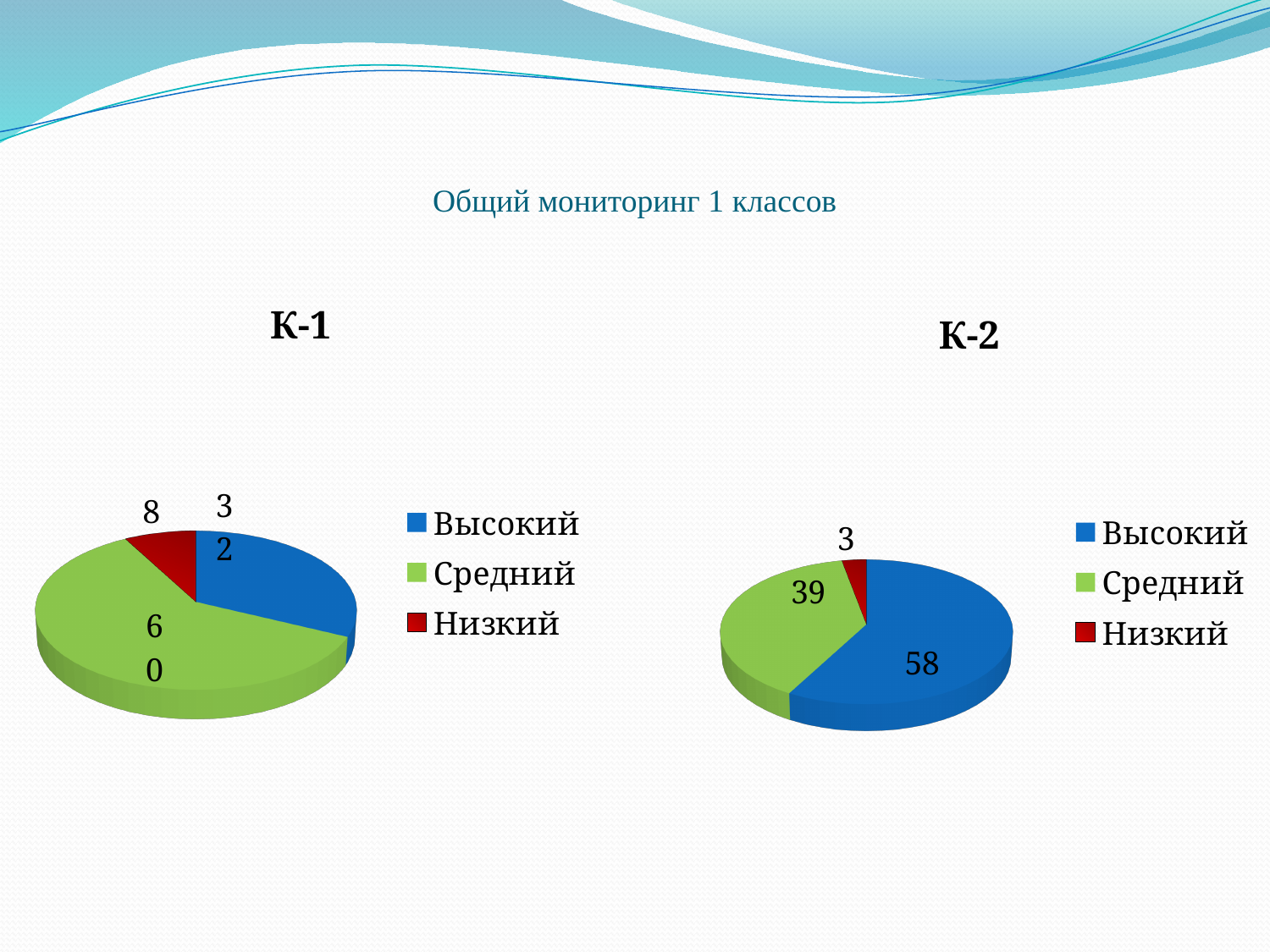
In the К-2 chart, which category has the smallest slice? Низкий In the К-1 chart, which category has the smallest slice? Низкий In the К-1 chart, which category has the largest slice? Средний In the К-1 chart, what is the value for Низкий? 8 In the К-2 chart, what is the value for Средний? 39 In the К-2 chart, what is the value for Низкий? 3 What is the title of the slide above the two charts? Общий мониторинг 1 классов In the К-2 chart, what is the value for Высокий? 58 How many categories does the legend of the К-2 chart list? 3 In the К-2 chart, what is the difference between Высокий and Средний? 19 What type of chart is used for К-1 and К-2? pie chart In the К-2 chart, which category has the largest slice? Высокий